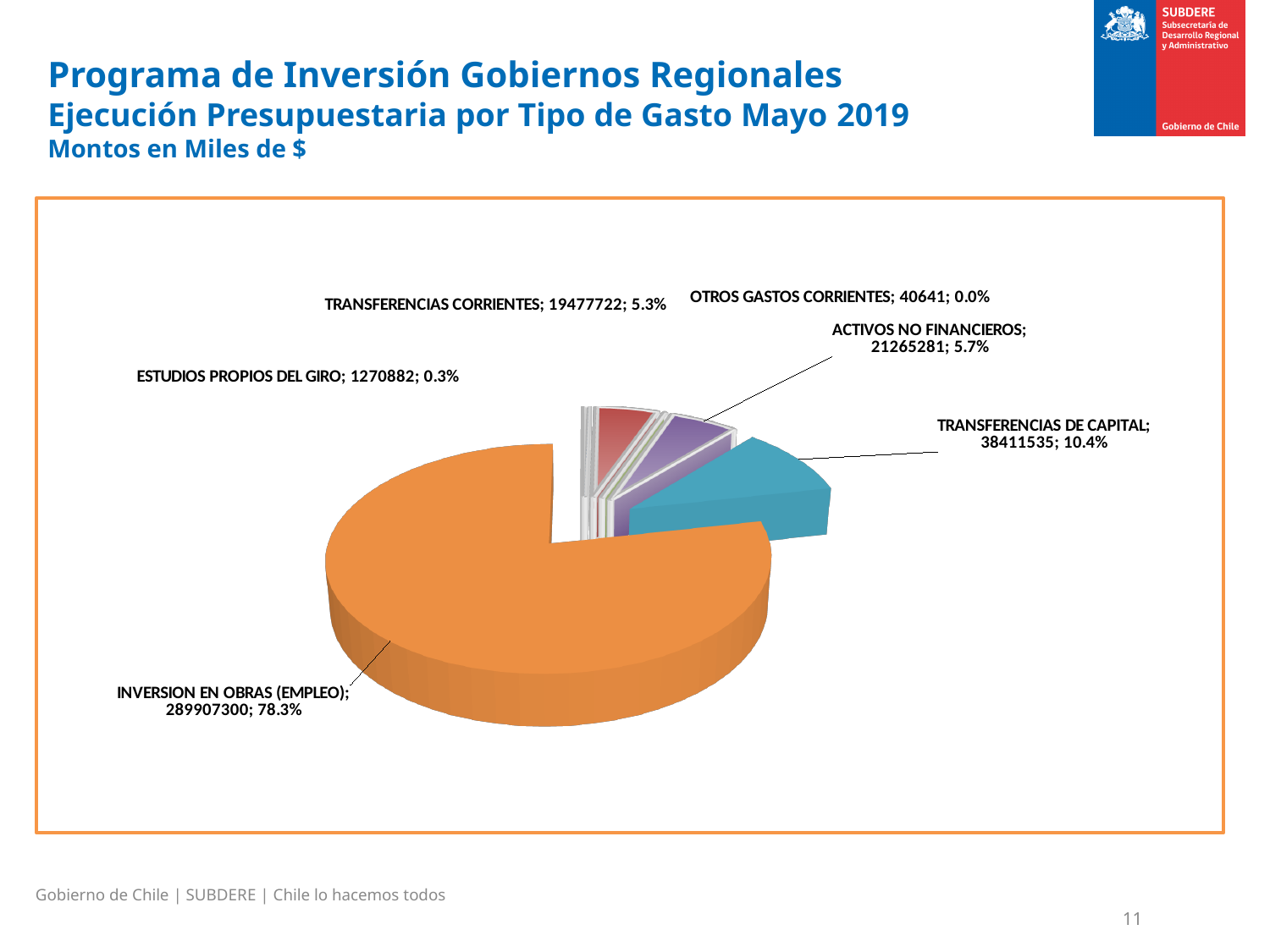
What is the difference in percentage share between TRANSFERENCIAS DE CAPITAL and TRANSFERENCIAS CORRIENTES? 5.1% Which category has the largest share of the pie? INVERSION EN OBRAS (EMPLEO) Which is larger, TRANSFERENCIAS DE CAPITAL or ACTIVOS NO FINANCIEROS? TRANSFERENCIAS DE CAPITAL What unit are the amounts in the chart expressed in, according to the slide subtitle? Miles de $ What is the value for INVERSION EN OBRAS (EMPLEO)? 289907300 What kind of chart is shown on the slide? Pie chart What share of the pie does TRANSFERENCIAS DE CAPITAL represent? 10.4% Which category has the smallest value? OTROS GASTOS CORRIENTES What is the difference between the values for TRANSFERENCIAS DE CAPITAL and ACTIVOS NO FINANCIEROS? 17146254 How many categories does the pie chart show? 6 What is the value for ACTIVOS NO FINANCIEROS? 21265281 What share of the pie does ESTUDIOS PROPIOS DEL GIRO represent? 0.3%